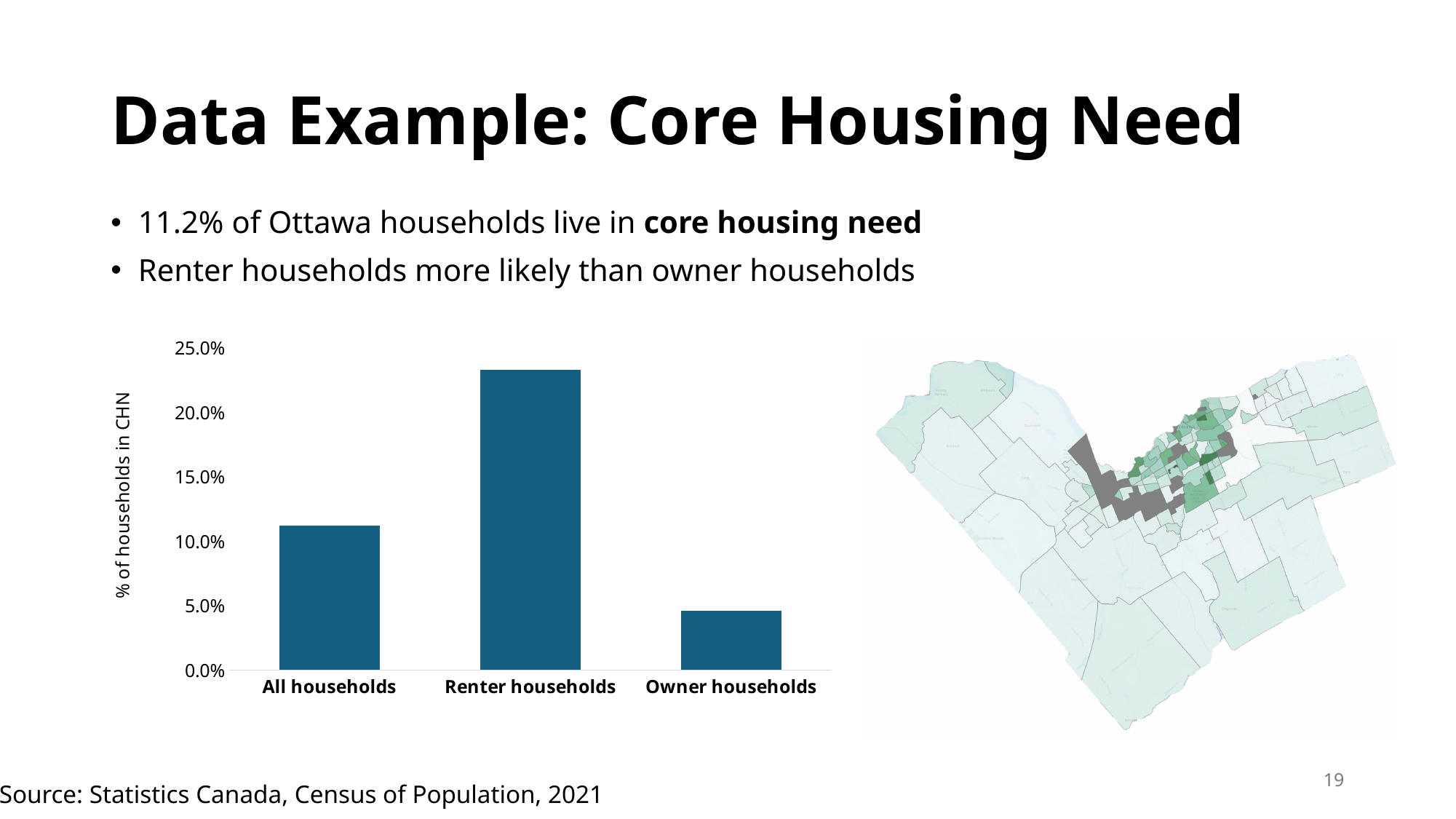
What kind of chart is shown on the left of the slide? bar chart Which is larger in the bar chart, Renter households or Owner households? Renter households Is the value for Owner households greater or less than 5.0%? less Which category has the lowest value in the bar chart? Owner households Which category has the highest value in the bar chart? Renter households What is the label on the vertical axis of the bar chart? % of households in CHN Which is larger in the bar chart, All households or Owner households? All households Is the value for Renter households greater or less than 25.0%? less Is the value for Renter households greater or less than 20.0%? greater What is the highest tick value shown on the vertical axis of the bar chart? 25.0% How many categories are plotted in the bar chart? 3